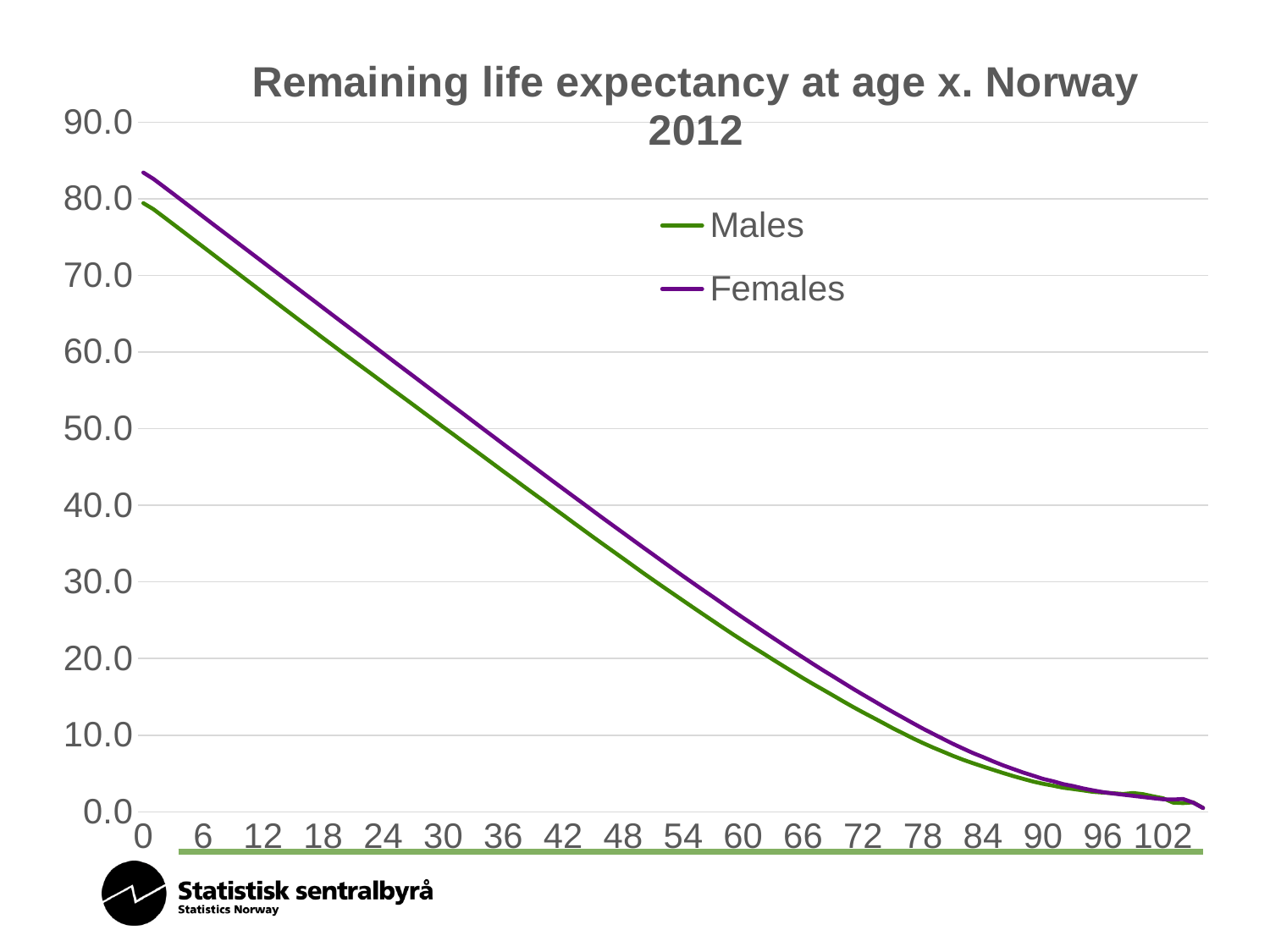
Is the value for Females at age 60 greater or less than 20.0? greater Is the value for Females at age 0 greater or less than 80.0? greater What kind of chart is shown on the slide? line chart Is the value for Males at age 0 greater or less than 70.0? greater How many series does the legend list? 2 What is the title of the chart? Remaining life expectancy at age x. Norway 2012 At which age is the remaining life expectancy for Females highest? 0 Do the values rise or fall as age increases along the x axis? fall At age 0, which series has the larger value, Males or Females? Females Which colour is used for the Females line? purple